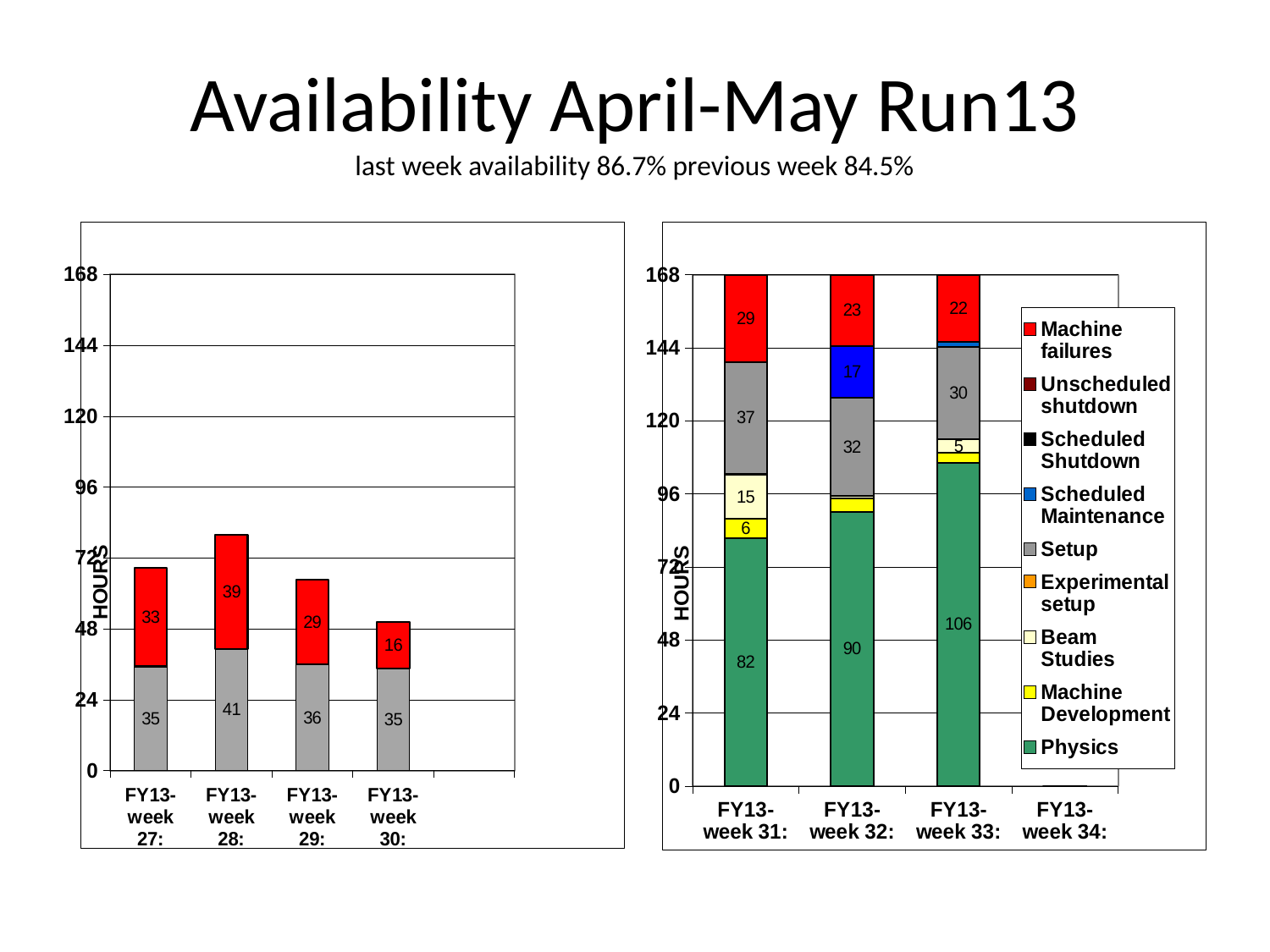
On the right chart, how many series does the legend list? 9 On the left chart, what is the value of the red segment for FY13-week 28? 39 On the left chart, what is the difference between the red segment for FY13-week 27 and the red segment for FY13-week 30? 17 On the right chart, what is the Physics value for FY13-week 33? 106 On the right chart, what is the Setup value for FY13-week 31? 37 On the left chart, what is the value of the gray segment for FY13-week 30? 35 What kind of chart is the right chart? Stacked bar chart On the left chart, what is the total height of the stacked bar for FY13-week 27? 68 On the right chart, is the Machine failures value larger for FY13-week 31 or FY13-week 33? FY13-week 31 On the left chart, which week has the largest red segment? FY13-week 28 On the left chart, which week has the smallest red segment? FY13-week 30 On the right chart, what is the Scheduled Maintenance value for FY13-week 32? 17